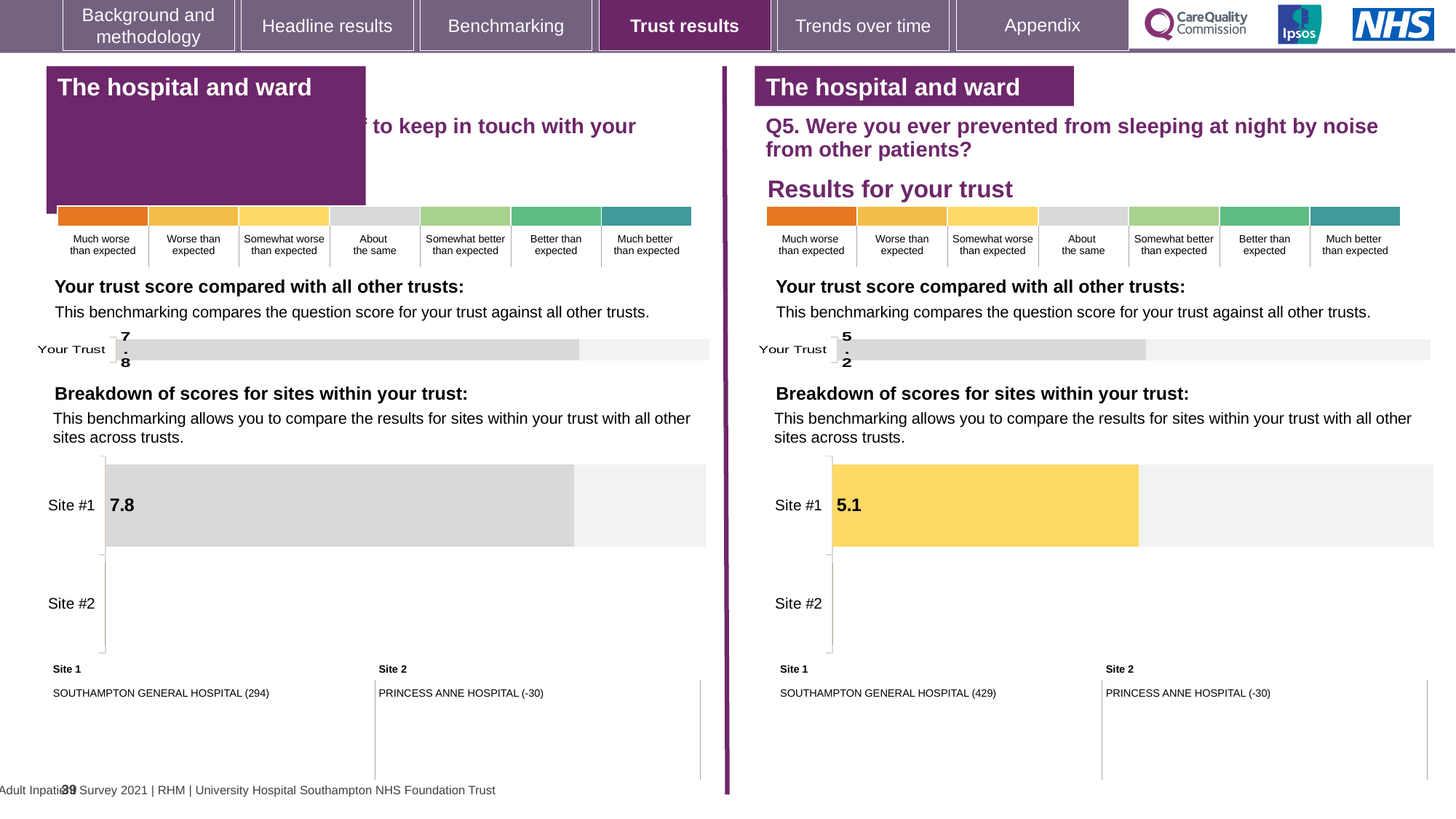
Which is larger: the Site #1 score on the left-hand panel or the Site #1 score on the right-hand panel (Q5)? Left-hand panel (7.8) On the right-hand panel (Q5), what colour is the Site #1 bar in the breakdown of scores chart? Yellow On the left-hand panel, what is the score shown for Site #1 in the breakdown of scores for sites chart? 7.8 On the left-hand panel, what is the score shown for Your Trust in the 'Your trust score compared with all other trusts' chart? 7.8 On the right-hand panel (Q5), which site has a bar plotted in the breakdown of scores chart? Site #1 On the right-hand panel (Q5, prevented from sleeping by noise from other patients), what is the score shown for Your Trust? 5.2 On the right-hand panel (Q5), which hospital is listed as Site 1? SOUTHAMPTON GENERAL HOSPITAL (429) What is the difference between the Site #1 score on the left-hand panel (7.8) and the Site #1 score on the right-hand panel (5.1)? 2.7 On the right-hand panel (Q5), what is the difference between the Your Trust score (5.2) and the Site #1 score (5.1)? 0.1 What type of chart is used to show the breakdown of scores for sites within your trust on the right-hand panel (Q5)? Bar chart On the right-hand panel (Q5), what is the score shown for Site #1 in the breakdown of scores for sites chart? 5.1 How many sites are listed in the breakdown of scores chart on the right-hand panel (Q5)? 2